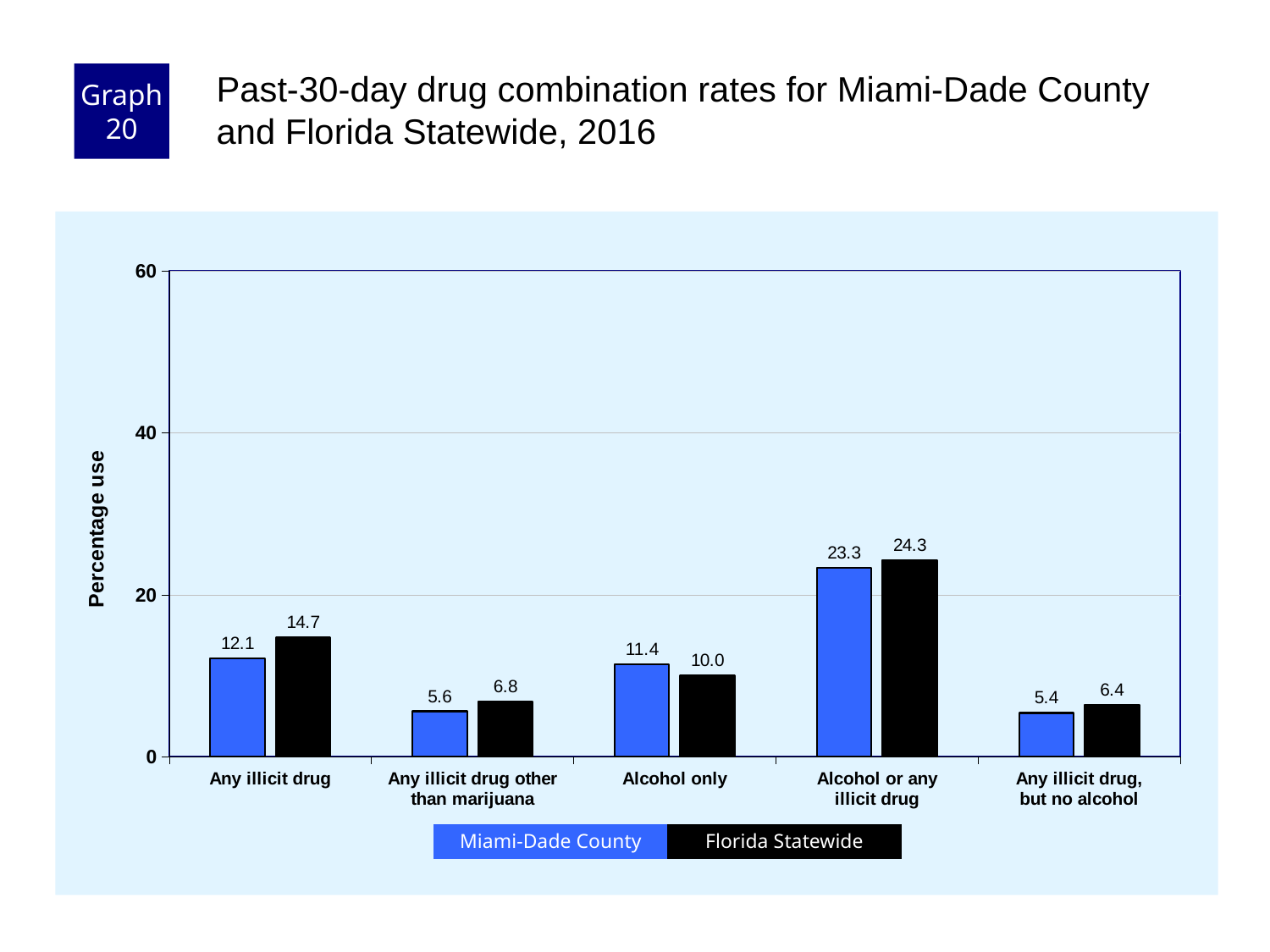
What is the Miami-Dade County value for Any illicit drug? 12.1 How many series does the legend list? 2 What is the label of the y axis? Percentage use How many categories are shown on the x axis? 5 What kind of chart is shown on the slide? bar chart Is the Florida Statewide value for Alcohol or any illicit drug greater or less than 20? greater Which category has the highest Miami-Dade County value? Alcohol or any illicit drug Which category has the lowest Florida Statewide value? Any illicit drug, but no alcohol Which is larger for Alcohol only: Miami-Dade County or Florida Statewide? Miami-Dade County What is the Florida Statewide value for Any illicit drug, but no alcohol? 6.4 What is the Florida Statewide value for Alcohol only? 10.0 What is the difference between the Florida Statewide and Miami-Dade County values for Any illicit drug? 2.6